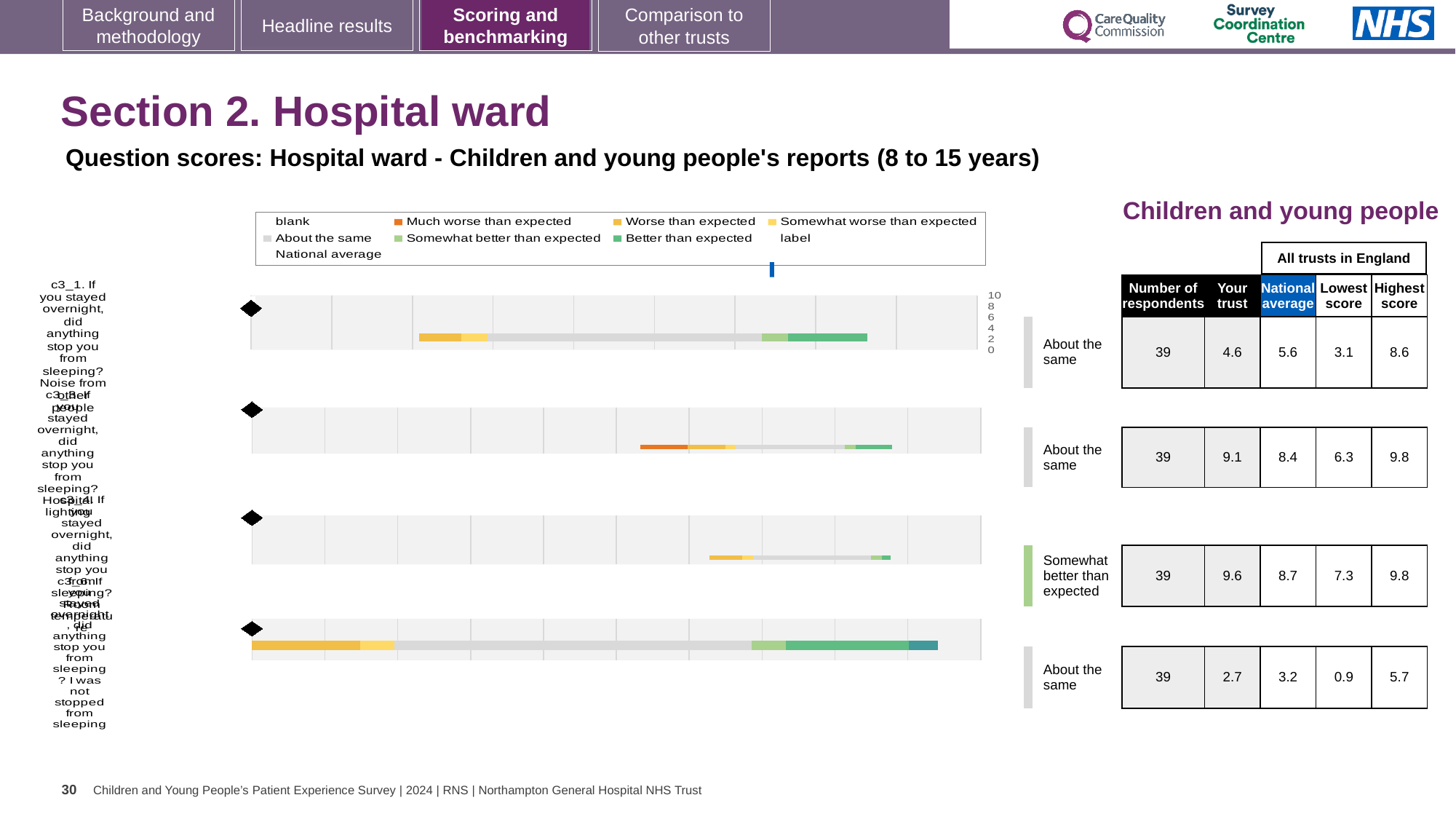
Which chart row has the lowest 'Your trust' score in the table? the fourth row (2.7) In the legend, what colour represents 'Much worse than expected'? orange What benchmark rating is given for the third chart row? Somewhat better than expected For the third chart row, what is the difference between the 'Your trust' score and the national average? 0.9 How many question score charts (rows) are shown on the slide? 4 What kind of chart is used to show the question scores on this slide? bar chart How many entries does the legend above the charts list? 9 For the second chart row, what is the national average score shown in the table? 8.4 For the second chart row, which is larger: the 'Your trust' score or the national average? Your trust (9.1) Which chart row has the highest 'Your trust' score in the table? the third row (9.6) For the top chart row, what is the 'Your trust' score shown in the table? 4.6 How many respondents are listed for each chart row in the table? 39